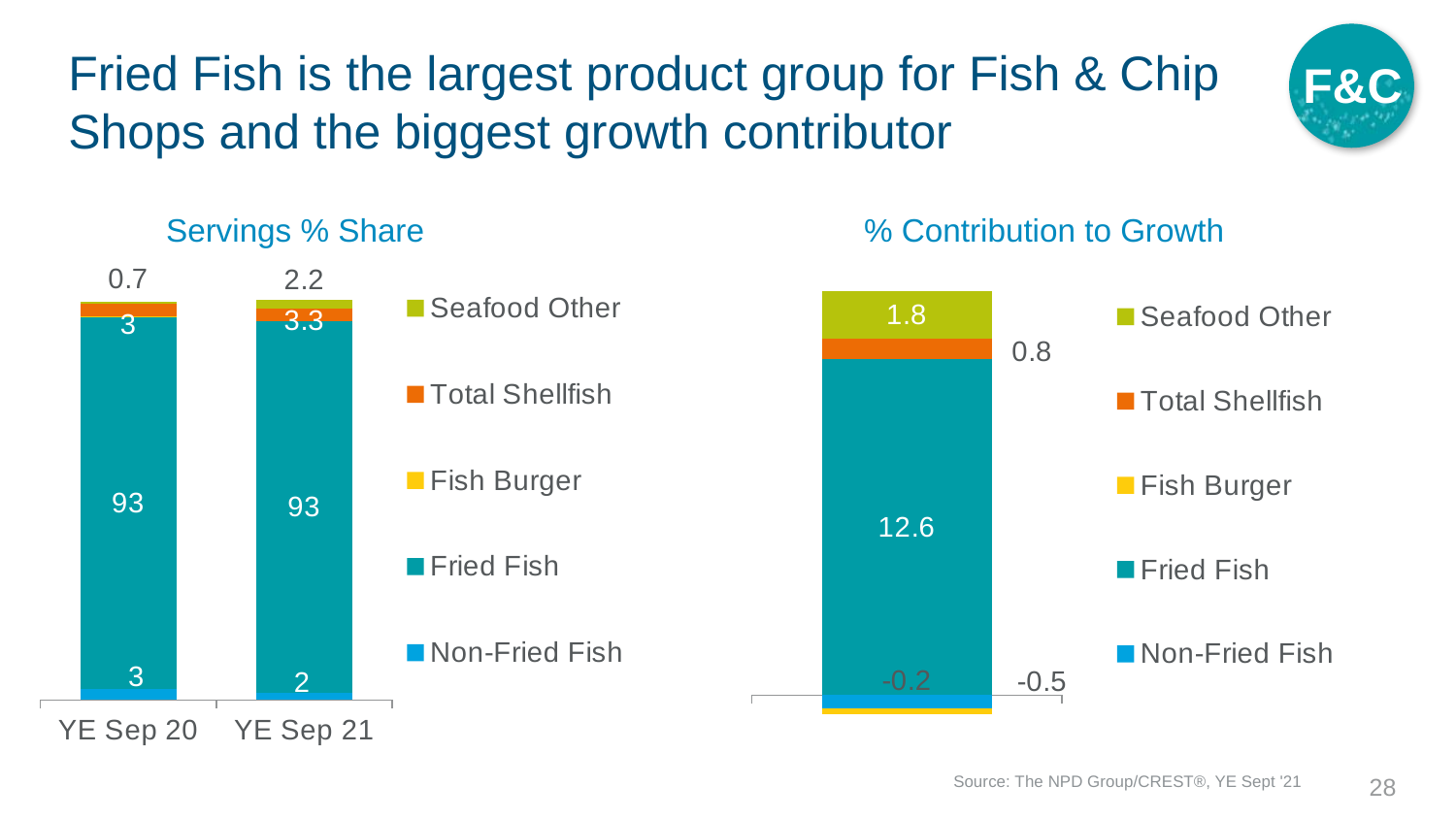
How many time periods are shown on the x axis of the 'Servings % Share' chart? 2 In the 'Servings % Share' chart, what is the Seafood Other share for YE Sep 21? 2.2 In the 'Servings % Share' chart, by how much did the Seafood Other share increase from YE Sep 20 to YE Sep 21? 1.5 How many series does the legend of the 'Servings % Share' chart list? 5 In the 'Servings % Share' chart, which product group has the largest share in YE Sep 21? Fried Fish In the 'Servings % Share' chart, what is the Fried Fish share for YE Sep 20? 93 In the '% Contribution to Growth' chart, what is the contribution of Fried Fish? 12.6 In the '% Contribution to Growth' chart, what is the contribution of Seafood Other? 1.8 In the '% Contribution to Growth' chart, how much larger is the Fried Fish contribution than the Seafood Other contribution? 10.8 In the 'Servings % Share' chart, what is the Non-Fried Fish share for YE Sep 21? 2 In the 'Servings % Share' chart, what is the Seafood Other share for YE Sep 20? 0.7 What kind of chart is the 'Servings % Share' chart on the left? Stacked bar chart